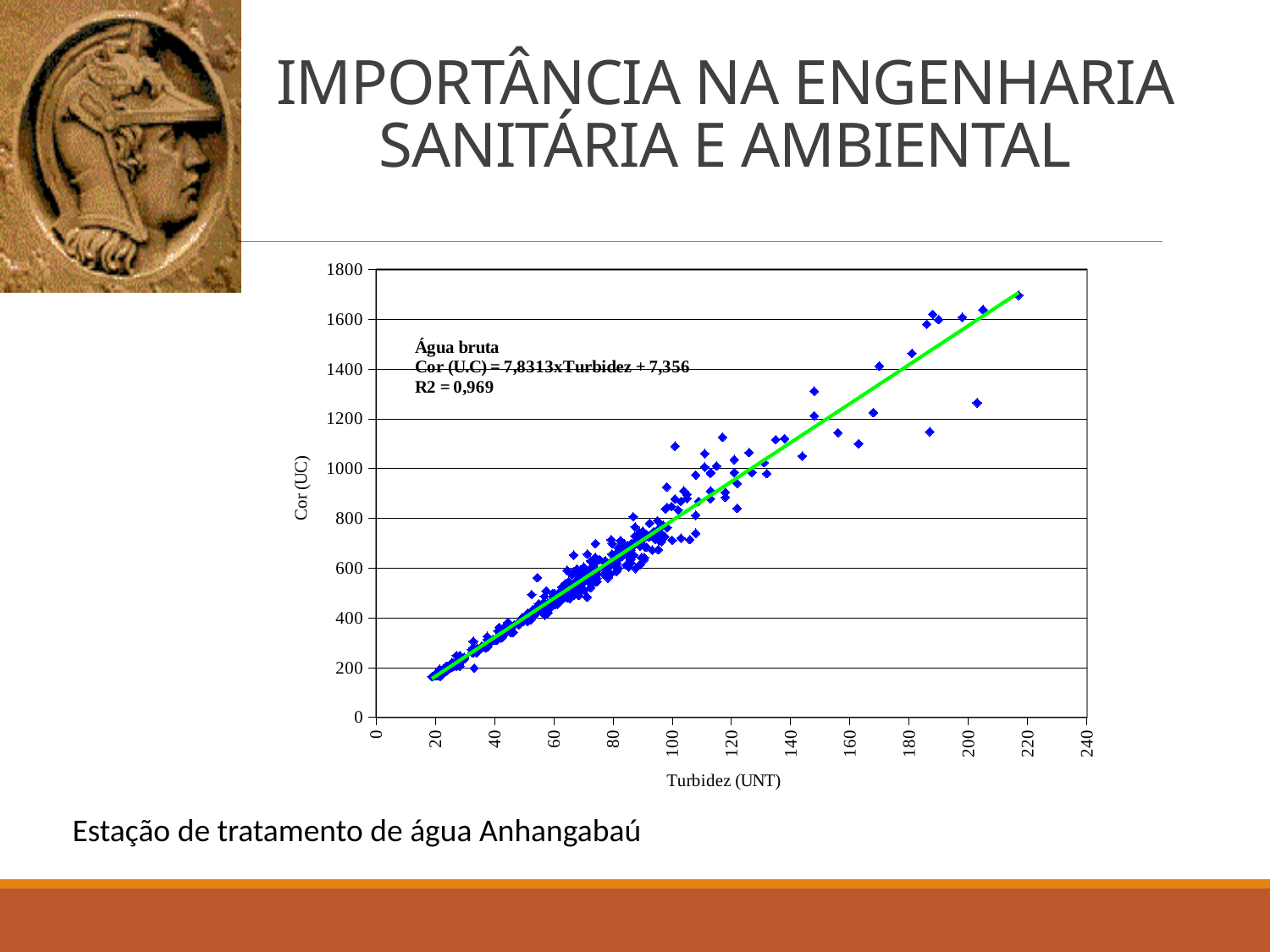
Is the largest Turbidez (UNT) value plotted greater or less than 200? greater What kind of chart is shown on the slide? scatter plot Is the highest Cor (UC) value plotted greater or less than 1600? greater Is the lowest Cor (UC) value plotted greater or less than 200? less What is the label of the x axis of the chart? Turbidez (UNT) What R2 value is printed on the chart? 0,969 Do the Cor (UC) values rise or fall as Turbidez (UNT) increases along the x axis? rise